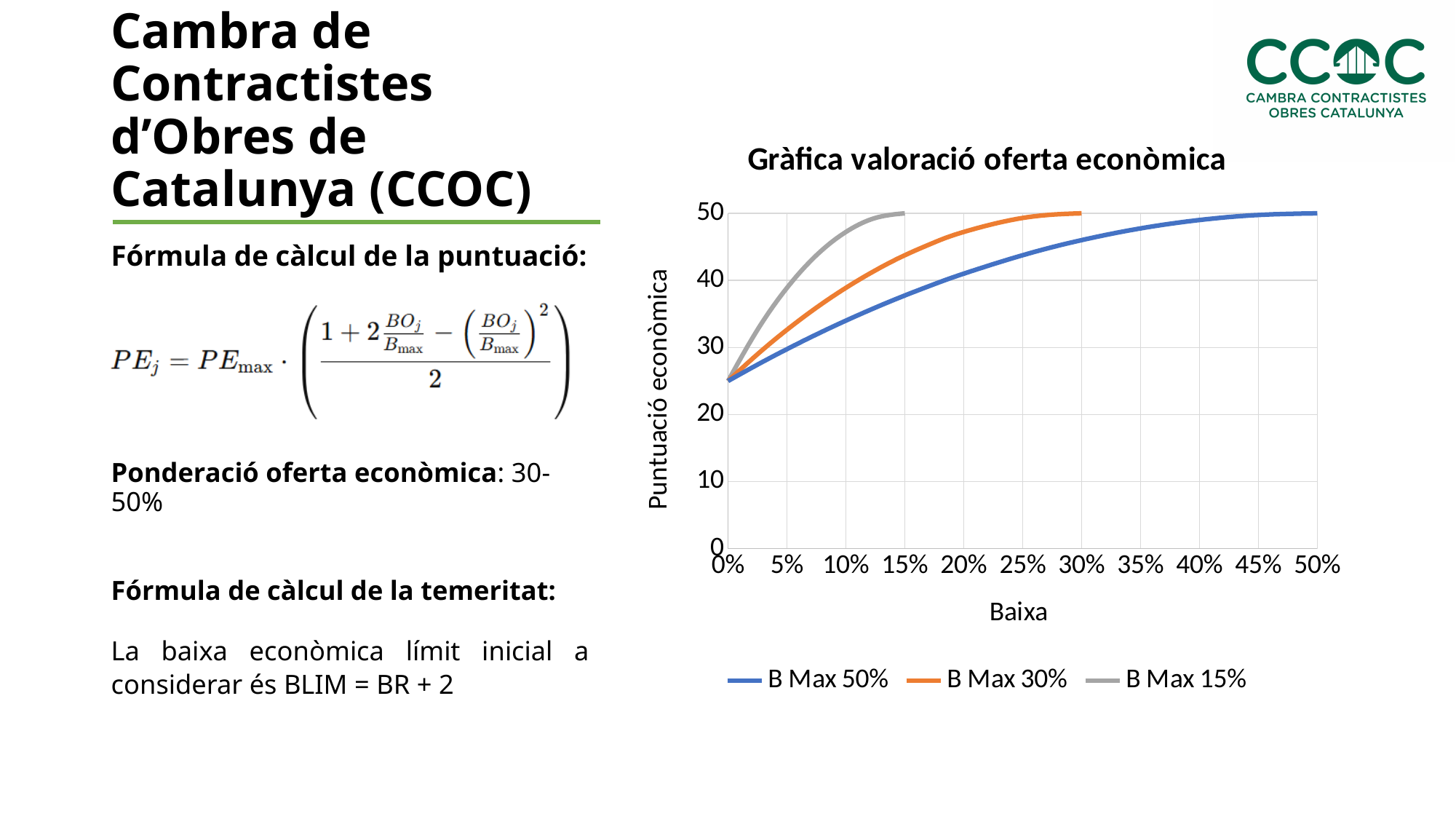
What is the title of the chart? Gràfica valoració oferta econòmica What kind of chart is shown on the slide? line chart At what Baixa value does the B Max 15% series reach a score of 50? 15% Is the value of the B Max 15% series at a Baixa of 10% greater or less than 40? greater At a Baixa of 10%, which series has the higher score, B Max 15% or B Max 50%? B Max 15% Is the value of the B Max 50% series at a Baixa of 0% greater or less than 30? less Do the values of the B Max 50% series rise or fall as Baixa increases along the x axis? rise At what Baixa value does the B Max 30% series reach a score of 50? 30% At a Baixa of 20%, which series has the higher score, B Max 30% or B Max 50%? B Max 30% What is the label of the vertical axis of the chart? Puntuació econòmica How many series does the legend of the chart list? 3 Is the value of the B Max 50% series at a Baixa of 25% greater or less than 40? greater